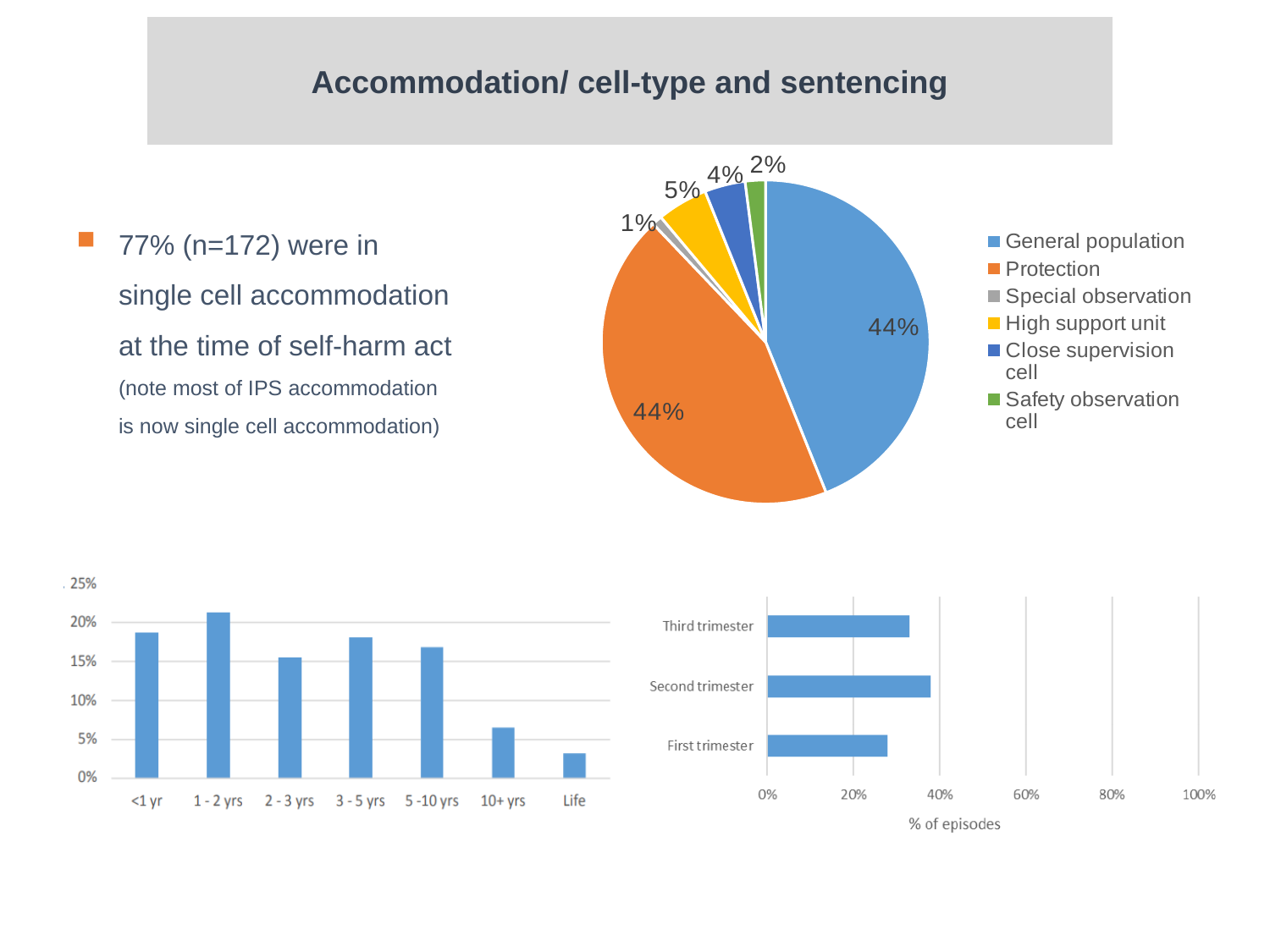
In the pie chart, which is larger, Close supervision cell or Safety observation cell? Close supervision cell In the bottom-left bar chart, how many sentence-length categories are shown on the x axis? 7 In the pie chart, what share of the pie is General population? 44% In the bottom-right bar chart, which trimester has the highest % of episodes? Second trimester In the bottom-left bar chart, is the value for 1 - 2 yrs greater or less than 20%? greater How many entries does the legend of the pie chart list? 6 In the bottom-left bar chart, which sentence-length category has the lowest value? Life In the bottom-right bar chart, is the value for First trimester greater or less than 20%? greater In the pie chart, what is the difference between the High support unit share and the Safety observation cell share? 3% In the pie chart, what share of the pie is High support unit? 5% In the pie chart, what share of the pie is Special observation? 1% What kind of chart is the bottom-left chart showing sentence lengths? bar chart